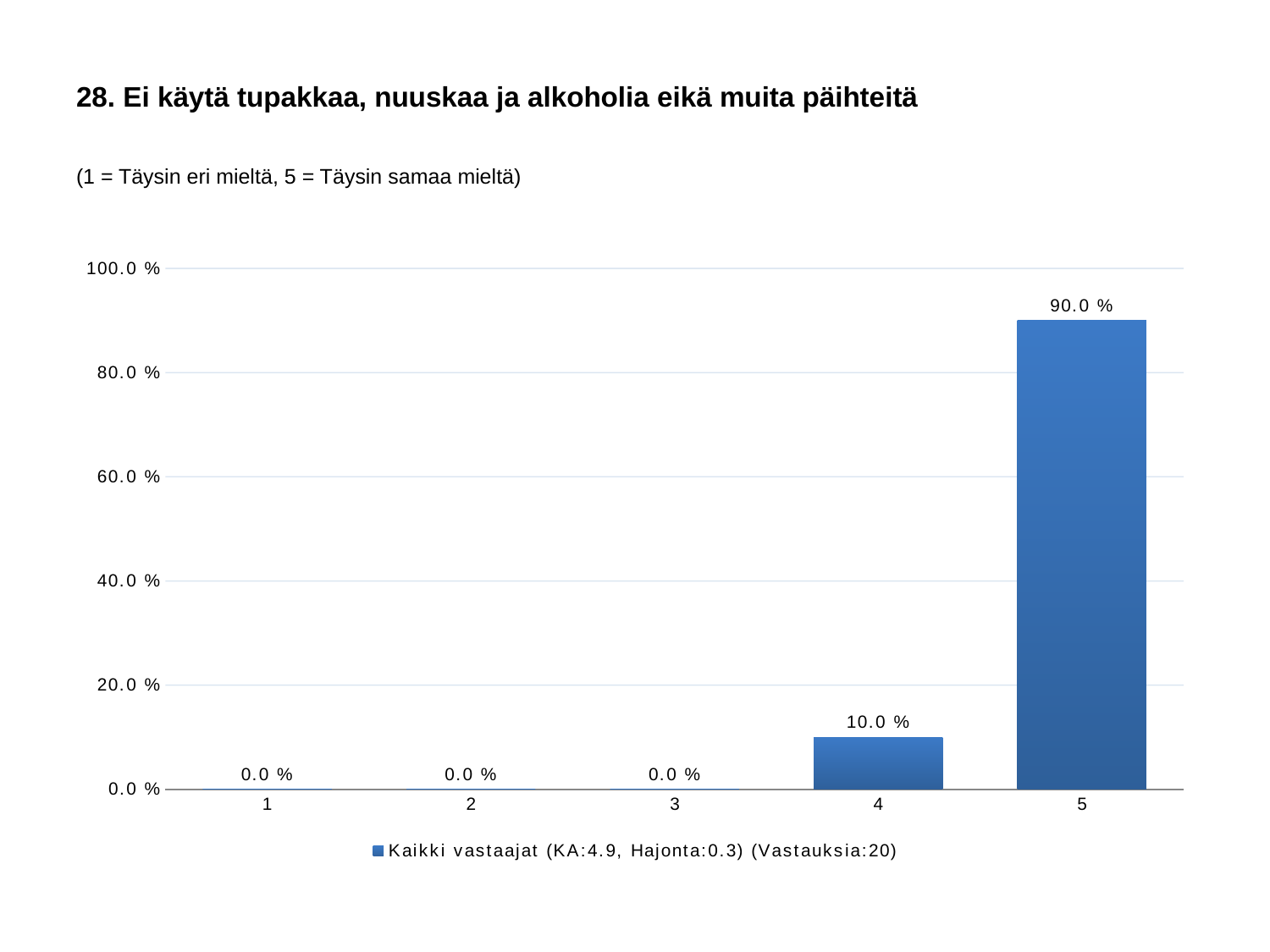
What is the value for category 1? 0.0 % What is the value for category 5? 90.0 % Which category has the highest value? 5 Do the values rise or fall from category 3 to category 5? rise What is the difference between the values for category 5 and category 4? 80.0 % How many responses (Vastauksia) does the legend report? 20 What kind of chart is shown? bar chart Is the value for category 5 greater or less than 80.0 %? greater Which is larger, the value for category 4 or the value for category 5? 5 What is the value for category 4? 10.0 % How many series does the legend list? 1 How many categories are shown on the x axis? 5